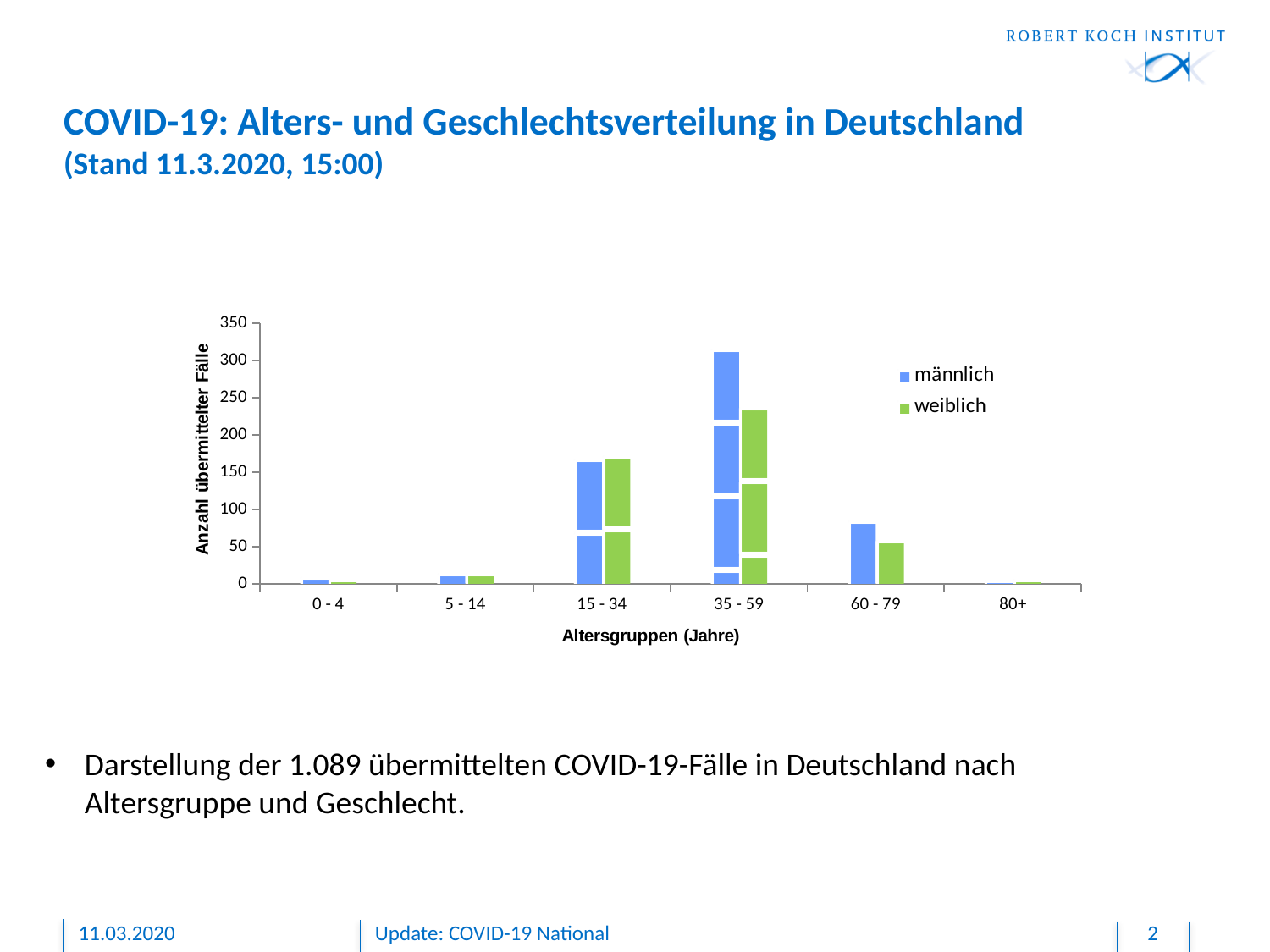
Is the männlich value for the 35 - 59 age group greater or less than 300? greater Is the männlich value for the 60 - 79 age group greater or less than 100? less Is the weiblich value for the 35 - 59 age group greater or less than 200? greater In the 35 - 59 age group, which is larger, männlich or weiblich? männlich What is the title of the y axis? Anzahl übermittelter Fälle In the 60 - 79 age group, which is larger, männlich or weiblich? männlich Which age group has the highest value for weiblich? 35 - 59 How many age groups are shown on the x axis? 6 How many series does the legend list? 2 What kind of chart is shown on the slide? bar chart Which age group has the highest value for männlich? 35 - 59